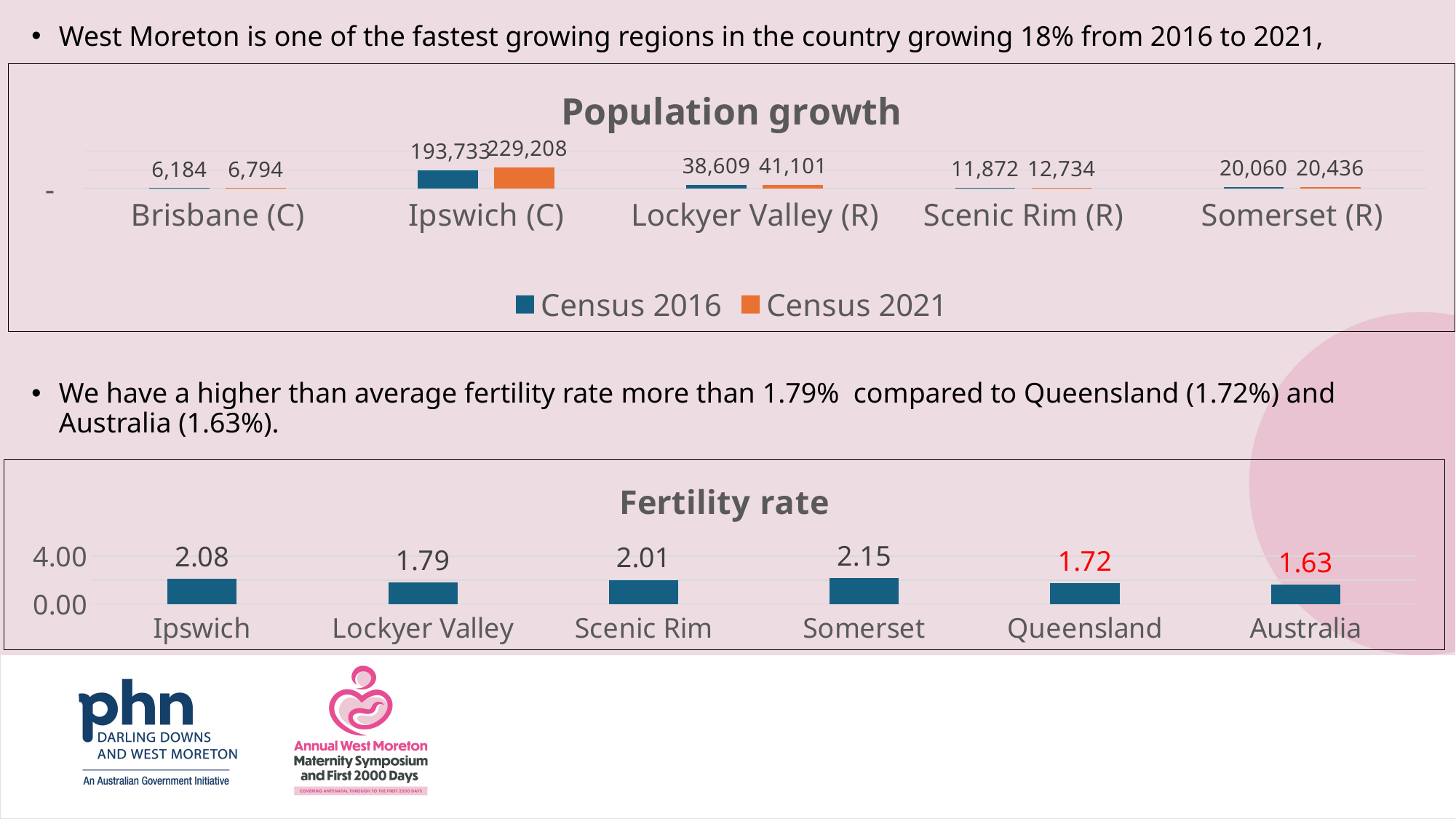
In the Population growth chart, what is the Census 2021 value for Ipswich (C)? 229,208 In the Population growth chart, which category has the highest Census 2021 value? Ipswich (C) In the Population growth chart, which category has the lowest Census 2016 value? Brisbane (C) In the Fertility rate chart, what is the difference between the values for Somerset and Lockyer Valley? 0.36 How many categories are shown in the Population growth chart? 5 In the Population growth chart, what is the Census 2016 value for Lockyer Valley (R)? 38,609 How many series does the legend of the Population growth chart list? 2 In the Fertility rate chart, which is larger, the value for Ipswich or the value for Queensland? Ipswich In the Population growth chart, what is the difference between the Census 2021 and Census 2016 values for Scenic Rim (R)? 862 In the Fertility rate chart, what is the value for Somerset? 2.15 In the Fertility rate chart, which category has the lowest value? Australia What kind of chart is the Fertility rate chart? Bar chart